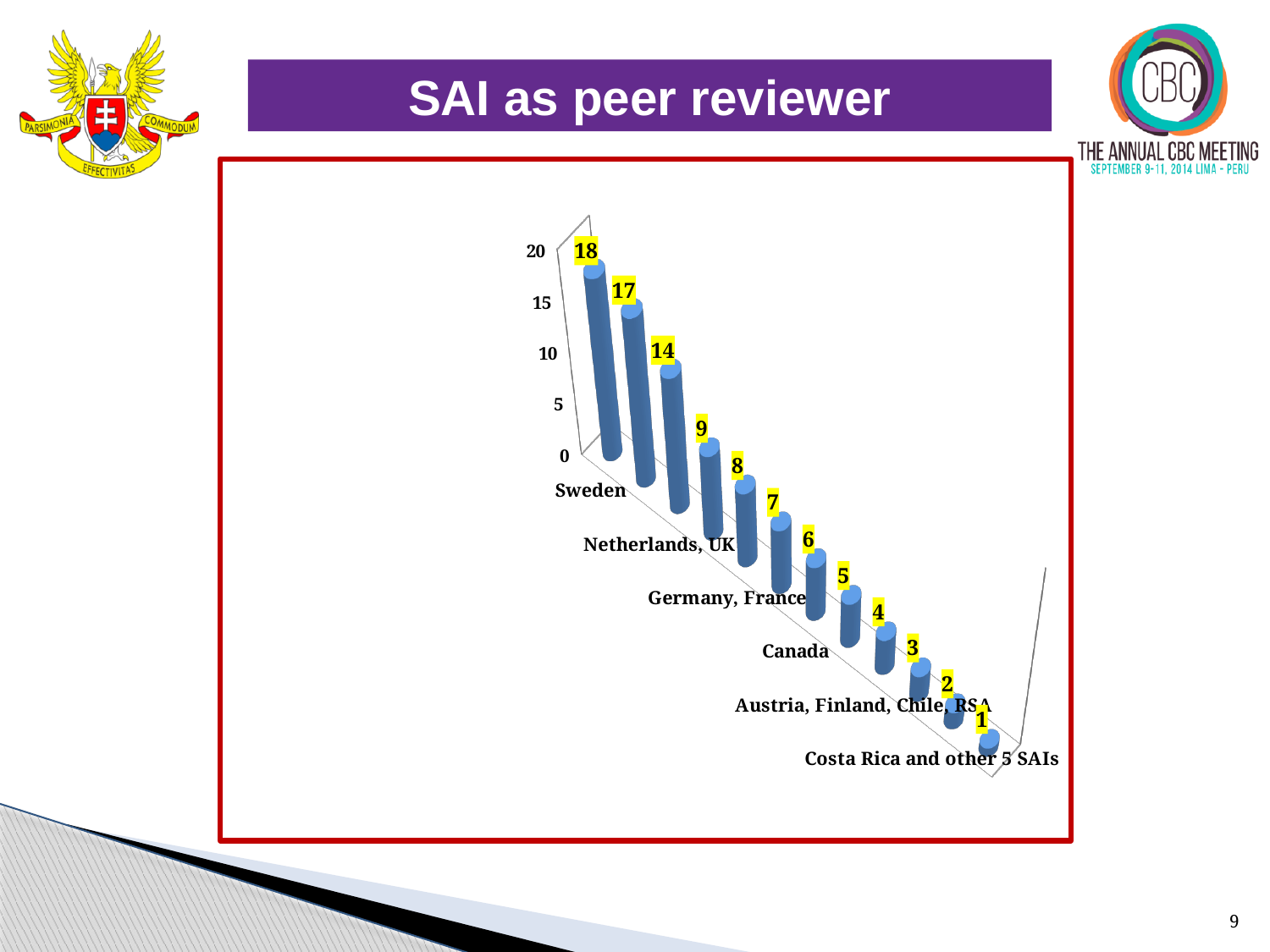
Is the value for Sweden greater or less than 15? greater What is the highest value shown in the chart? 18 What colour are the data label backgrounds in the chart? yellow How many bars are plotted in the chart? 12 Do the values rise or fall moving from the first bar to the last bar? fall What is the value for Sweden? 18 What is the lowest value shown in the chart? 1 What is the difference between the first bar (18) and the third bar (14)? 4 What is the difference between the highest value (18) and the second highest value (17)? 1 Which category has the highest value in the chart? Sweden What is the title of the slide containing the chart? SAI as peer reviewer What kind of chart is shown on the slide? bar chart